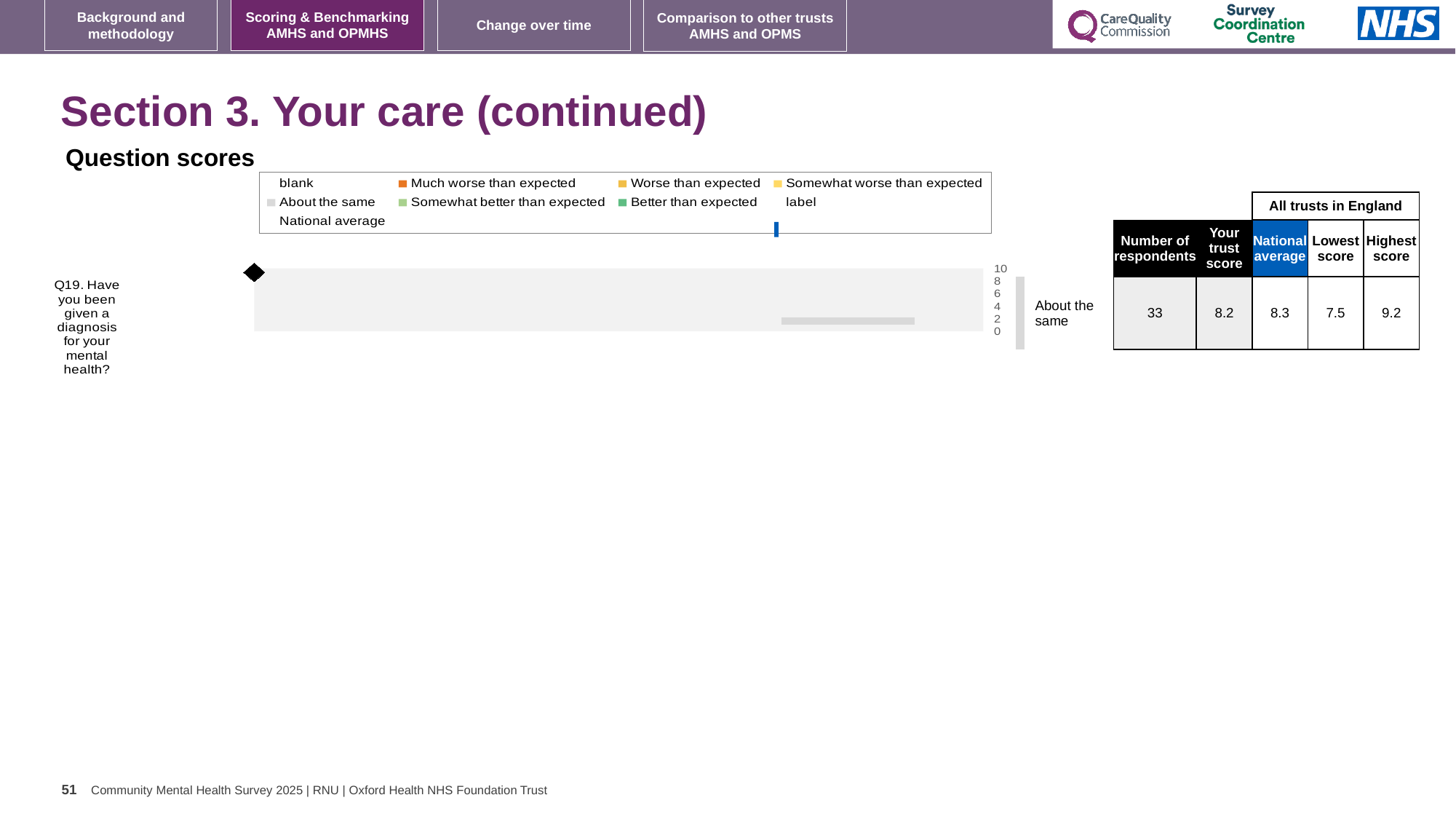
What benchmark category is shown for Q19 in the question scores chart? About the same What is the highest score among all trusts in England for Q19? 9.2 What is the trust score for Q19? 8.2 How many questions are plotted in the question scores chart? 1 What kind of chart is used to show the question scores? bar chart What is the national average score for Q19? 8.3 What is the number of respondents for Q19? 33 What is the lowest score among all trusts in England for Q19? 7.5 What is the difference between the highest and lowest scores for Q19? 1.7 Which question is plotted in the question scores chart? Q19. Have you been given a diagnosis for your mental health? For Q19, which is larger: the trust score or the national average? national average Is the trust score for Q19 greater or less than 6 on the chart axis? greater